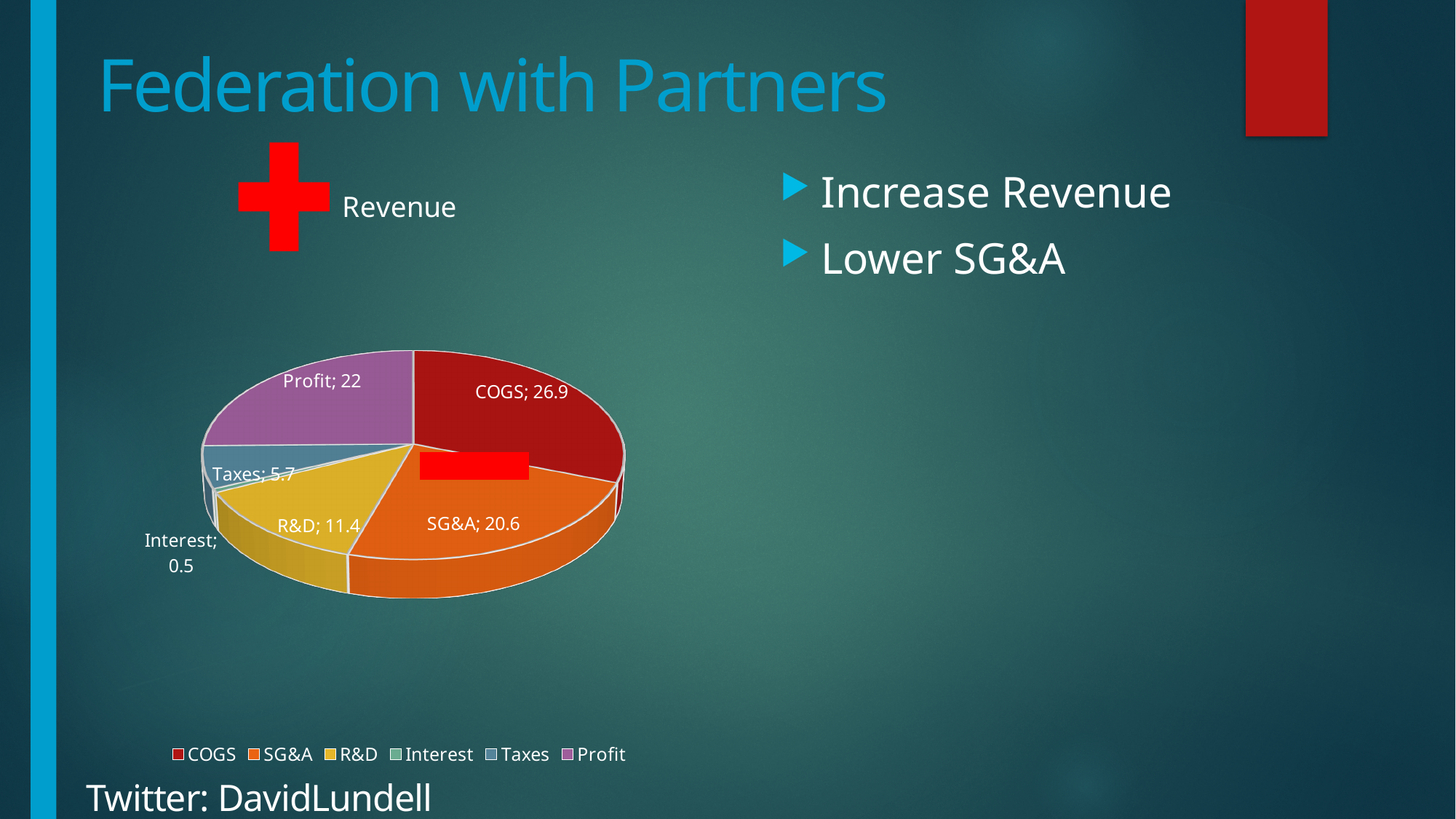
What is the value for SG&A in the pie chart? 20.6 Which category has the smallest slice in the pie chart? Interest Which is larger in the pie chart, Profit or R&D? Profit What is the value for Profit in the pie chart? 22 What kind of chart is shown on the slide? Pie chart How many categories does the pie chart's legend list? 6 What is the value for Taxes in the pie chart? 5.7 Which category has the largest slice in the pie chart? COGS What is the difference between the COGS value and the SG&A value in the pie chart? 6.3 What is the value for COGS in the pie chart? 26.9 What is the value for Interest in the pie chart? 0.5 What is the value for R&D in the pie chart? 11.4